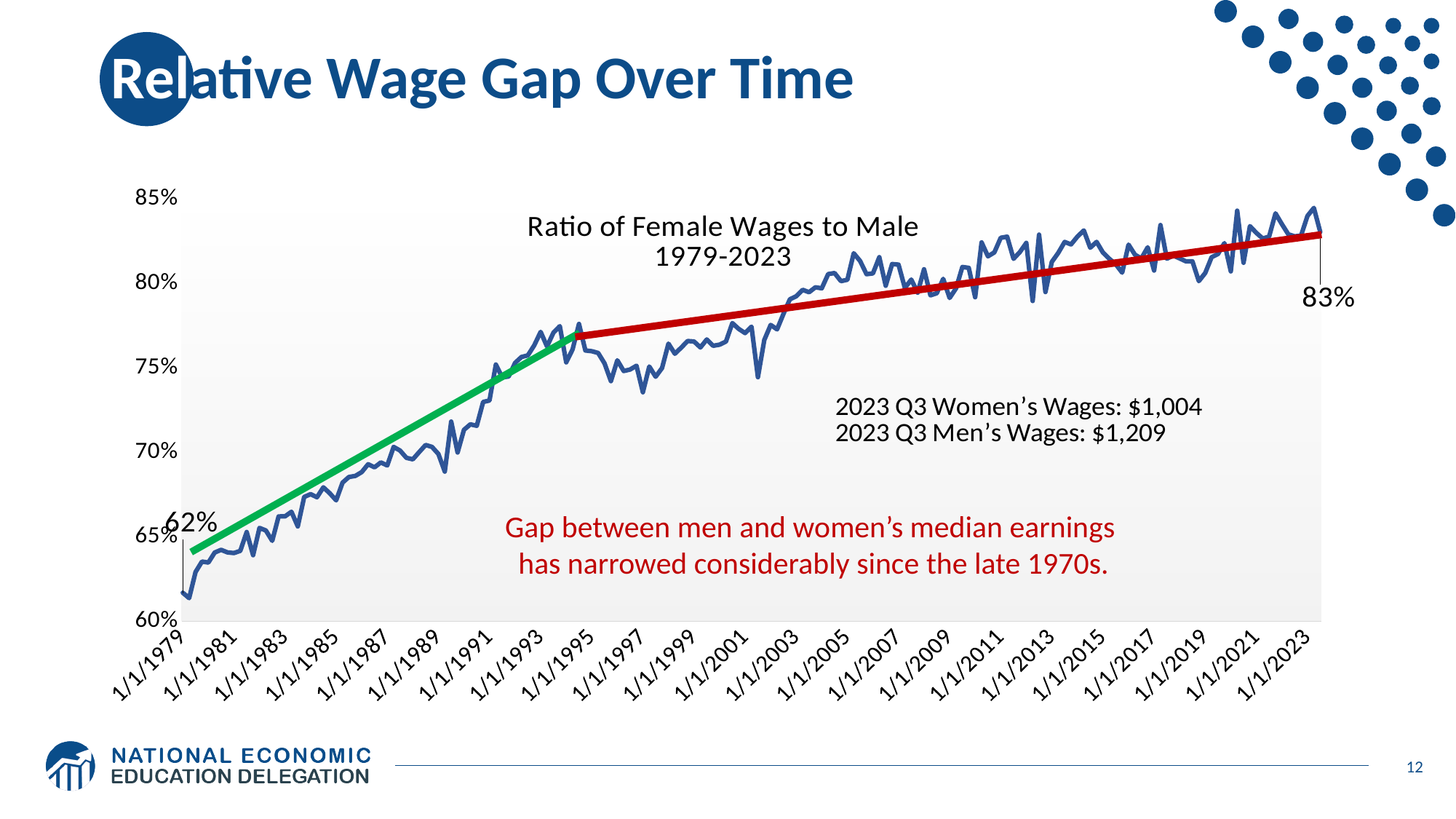
What is the ratio of female wages to male at the start of the series in 1979? 62% What is the ratio of female wages to male at the end of the series in 2023? 83% How many date labels are shown on the x axis? 23 What were 2023 Q3 men's wages according to the annotation on the chart? $1,209 Which is larger, the ratio in 1979 or the ratio in 2023? 2023 By how many percentage points did the ratio of female wages to male rise from 1979 to 2023? 21 percentage points Is the ratio of female wages to male around 1/1/1985 greater or less than 70%? less Does the ratio of female wages to male generally rise or fall from 1979 to 2023? rise What were 2023 Q3 women's wages according to the annotation on the chart? $1,004 What kind of chart is shown on the slide? line chart What is the title of the chart? Ratio of Female Wages to Male 1979-2023 Is the ratio of female wages to male around 1/1/2011 greater or less than 80%? greater